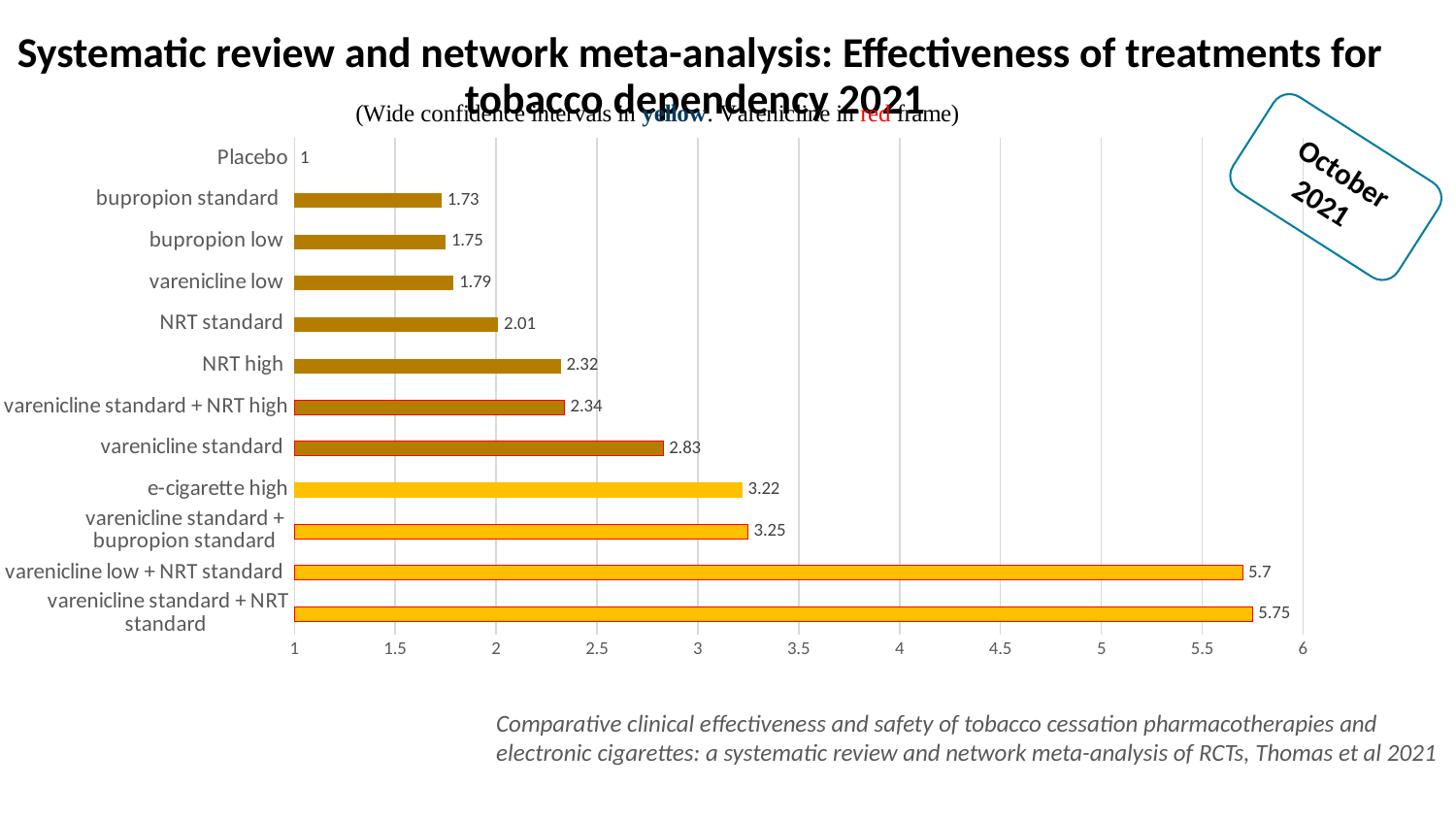
What is the value for NRT high? 2.32 Which is larger, the value for e-cigarette high or the value for varenicline standard? e-cigarette high How many categories are shown in the chart? 12 Which category has the highest value? varenicline standard + NRT standard What kind of chart is shown on the slide? bar chart What is the value for varenicline standard? 2.83 What is the difference between the values for varenicline standard and varenicline low? 1.04 What is the value for varenicline low + NRT standard? 5.7 Is the value for varenicline standard greater or less than 2.5? greater What is the value for e-cigarette high? 3.22 Which category has the lowest value? Placebo What is the difference between the values for NRT high and NRT standard? 0.31